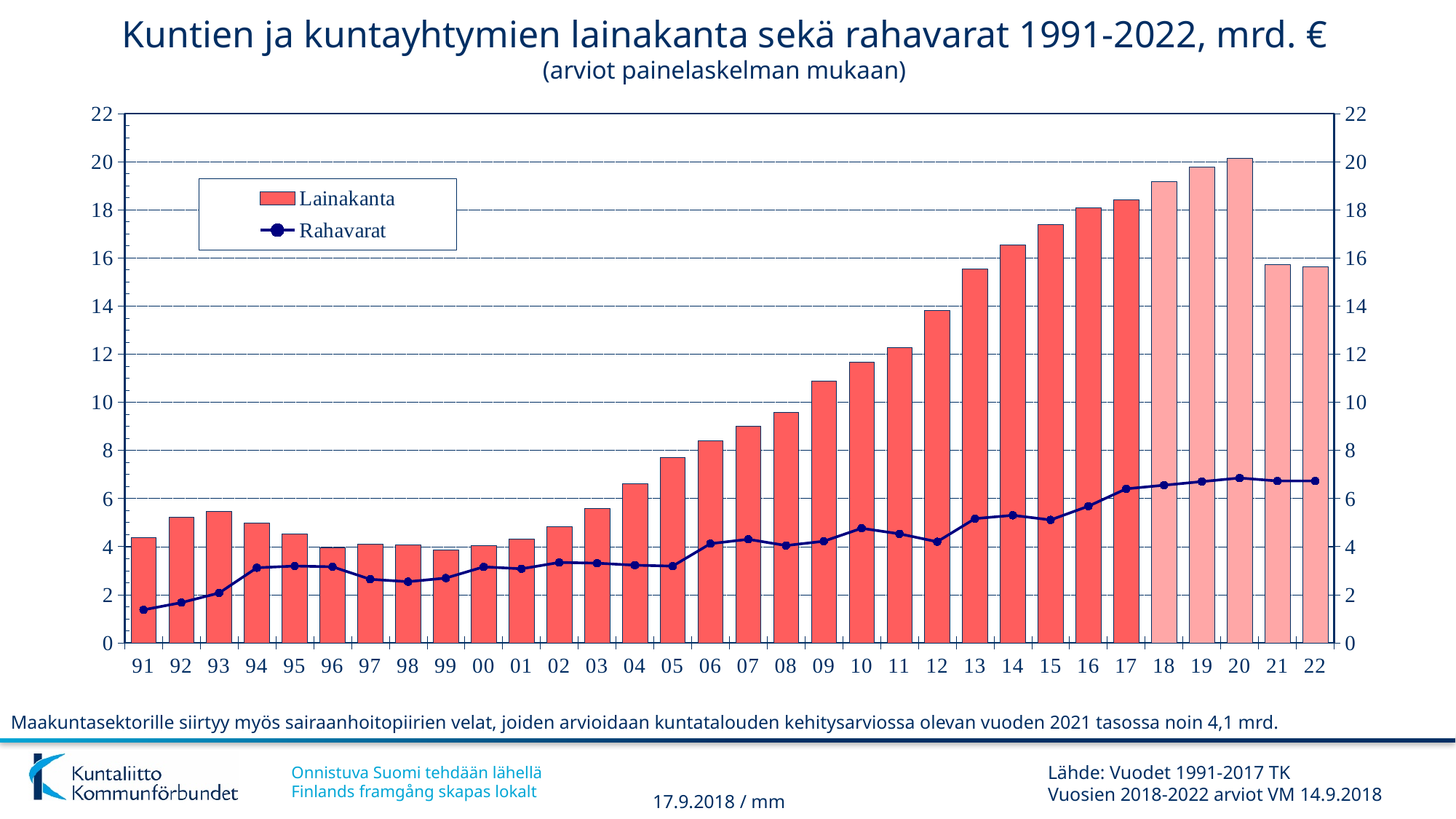
Is the Lainakanta value for 05 greater or less than 8? less Do the Lainakanta bars rise or fall from 05 to 20? rise Which year has the larger Lainakanta value, 20 or 21? 20 Is the Rahavarat value for 91 greater or less than 2? less What kind of chart is shown on the slide? A bar chart combined with a line chart Is the Lainakanta value for 19 greater or less than 18? greater How many series does the legend list? 2 Which year has the larger Rahavarat value, 10 or 12? 10 How many years are shown on the x axis? 32 In which year is the Lainakanta bar highest? 20 What are the two series named in the legend? Lainakanta and Rahavarat In which year is the Rahavarat value lowest? 91